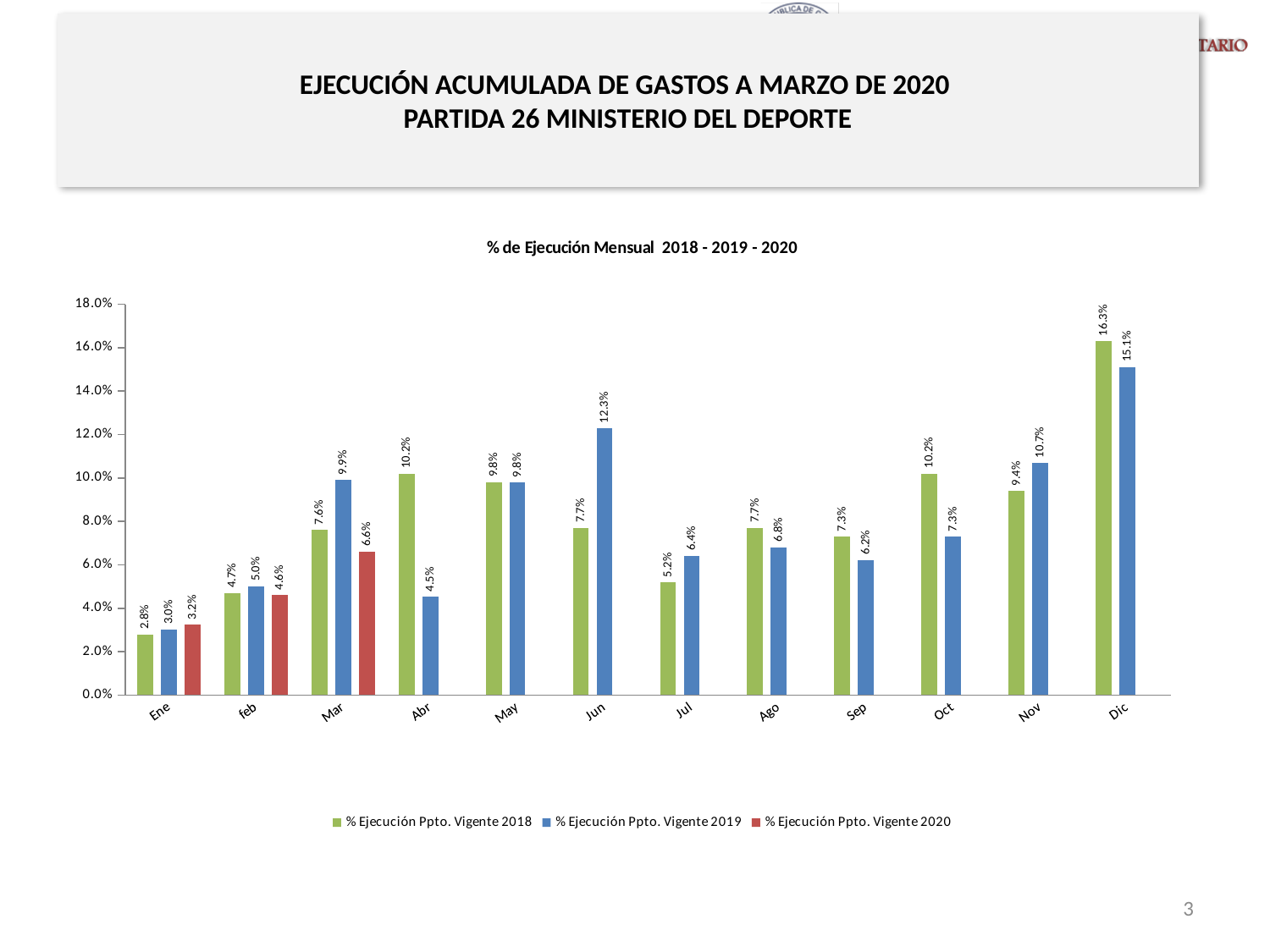
What kind of chart is shown on the slide? Bar chart Which month has the highest value for % Ejecución Ppto. Vigente 2018? Dic What is the difference between the 2018 and 2019 values for Dic? 1.2% What is the difference between the 2019 and 2018 values for Jun? 4.6% Which is larger for Abr: the 2018 value or the 2019 value? 2018 value (10.2%) How many months are shown on the x axis? 12 What is the value of % Ejecución Ppto. Vigente 2019 for Mar? 9.9% What is the value of % Ejecución Ppto. Vigente 2020 for feb? 4.6% What is the title of the chart? % de Ejecución Mensual 2018 - 2019 - 2020 What is the value of % Ejecución Ppto. Vigente 2018 for Oct? 10.2% Which month has the lowest value for % Ejecución Ppto. Vigente 2019? Ene How many series does the legend list? 3